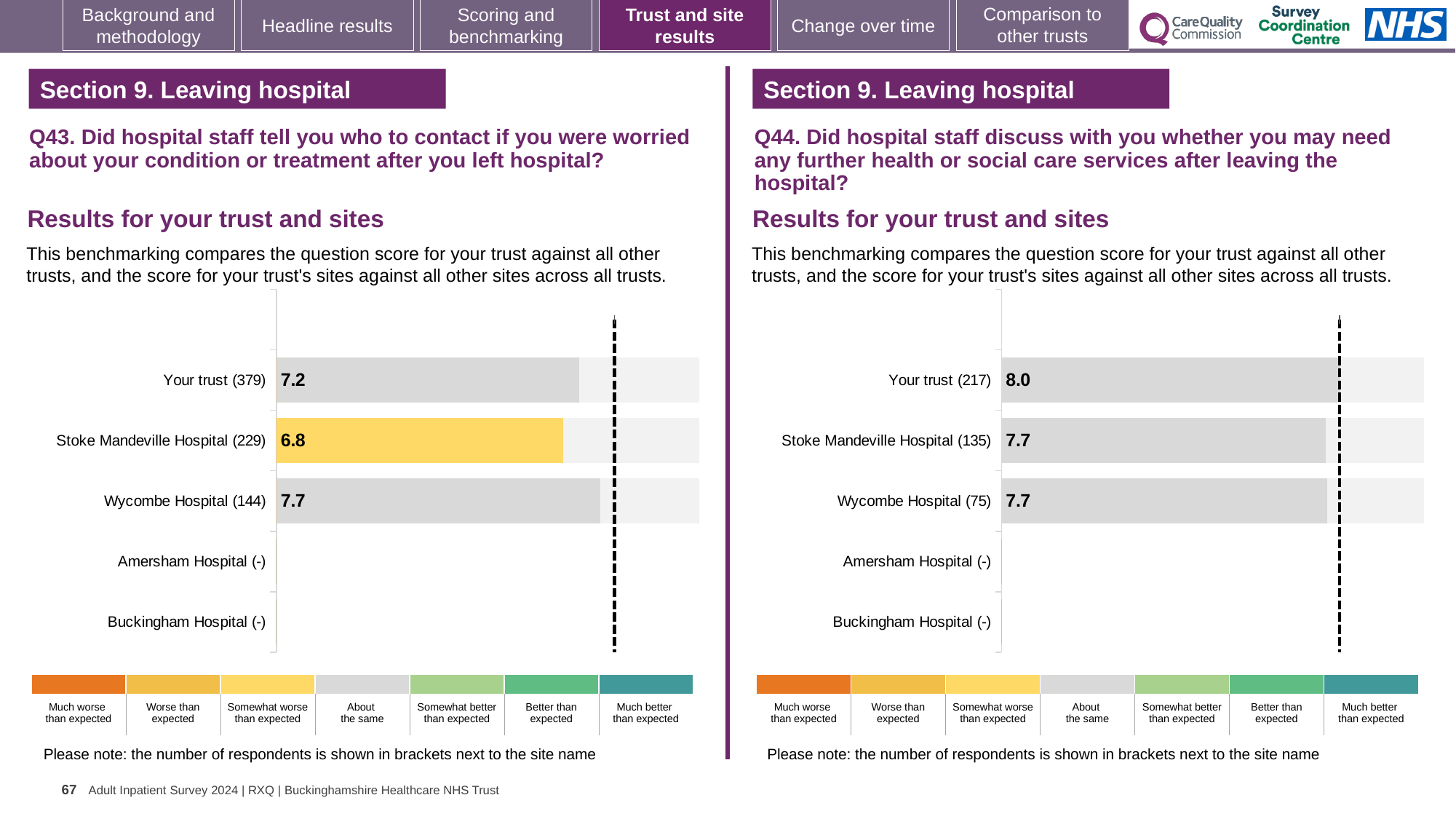
In the Q43 chart on the left, which site or trust row has the lowest score? Stoke Mandeville Hospital In the Q44 chart on the right, what is the difference between the scores for Your trust and Stoke Mandeville Hospital? 0.3 In the Q43 chart on the left, what colour is the bar for Stoke Mandeville Hospital? Yellow In the Q44 chart on the right, which row has the highest score? Your trust What type of chart is used on this slide? Bar chart In the Q43 chart on the left, what is the score for Stoke Mandeville Hospital? 6.8 In the Q43 chart on the left, what is the score for Your trust? 7.2 In the Q43 chart on the left, which site or trust row has the highest score? Wycombe Hospital In the Q44 chart on the right, how many respondents are shown for Your trust? 217 In the Q44 chart on the right, what is the score for Your trust? 8.0 In the Q43 chart on the left, what is the difference between the scores for Wycombe Hospital and Stoke Mandeville Hospital? 0.9 In the Q44 chart on the right, what is the score for Wycombe Hospital? 7.7